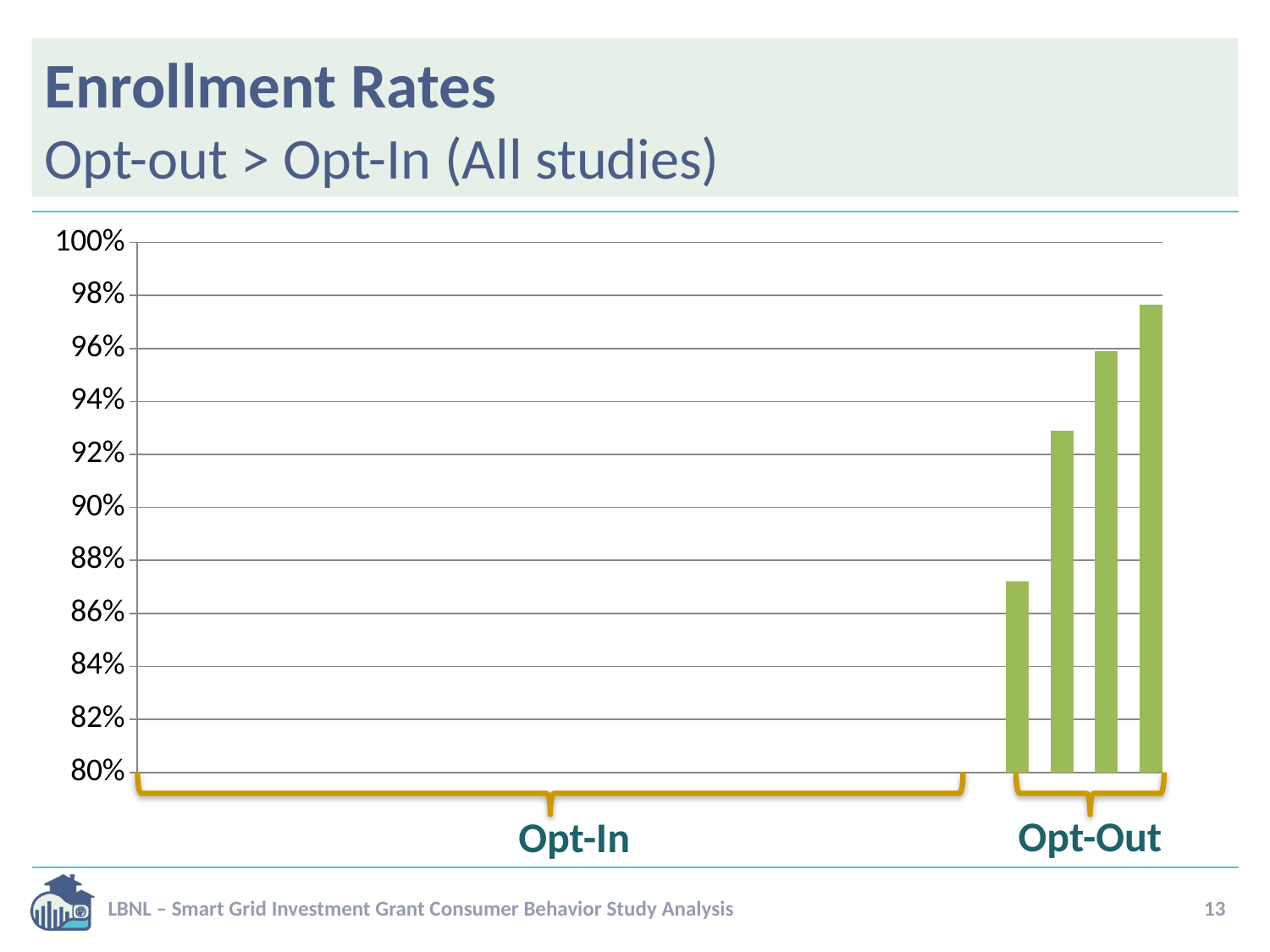
Is the value of the shortest visible Opt-Out bar greater or less than 88%? less How many bars are visible in the Opt-Out group? 4 Which is larger: the leftmost Opt-Out bar or the rightmost Opt-Out bar? the rightmost Opt-Out bar Is the value of the tallest Opt-Out bar greater or less than 96%? greater Which Opt-Out bar is the tallest: the leftmost or the rightmost? the rightmost What are the two group labels shown below the x axis? Opt-In and Opt-Out What is the lowest value shown on the y axis? 80% Do the Opt-Out bars rise or fall from left to right? rise What kind of chart is shown on the slide? bar chart Is the value of the second Opt-Out bar from the left greater or less than 92%? greater